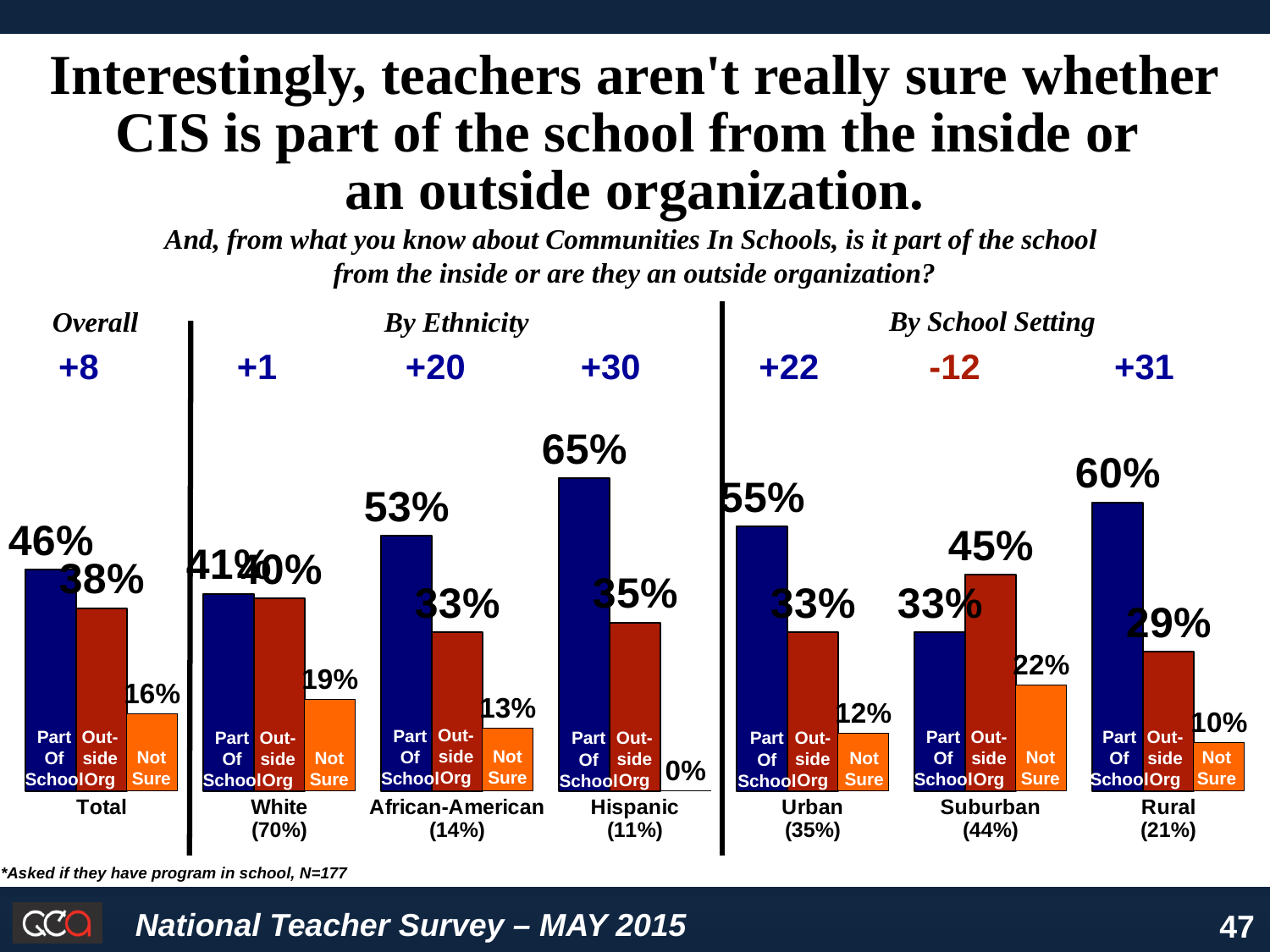
What percentage of teachers in the Total group said they were not sure? 16% Which group has the highest 'Part Of School' percentage? Hispanic How many groups (categories) are shown in the chart? 7 What percentage of Rural teachers said CIS is part of the school? 60% What percentage of Suburban teachers said CIS is an outside organization? 45% What is the net score shown above the Rural group? +31 Which group is the only one with a negative net score shown above its bars? Suburban What is the difference between the 'Part Of School' and 'Outside Org' percentages for Urban teachers? 22% What type of chart is shown on the slide? Bar chart Which is larger for Suburban teachers: 'Part Of School' or 'Outside Org'? Outside Org Which group has the lowest 'Not Sure' percentage? Hispanic What percentage of Hispanic teachers said CIS is part of the school? 65%